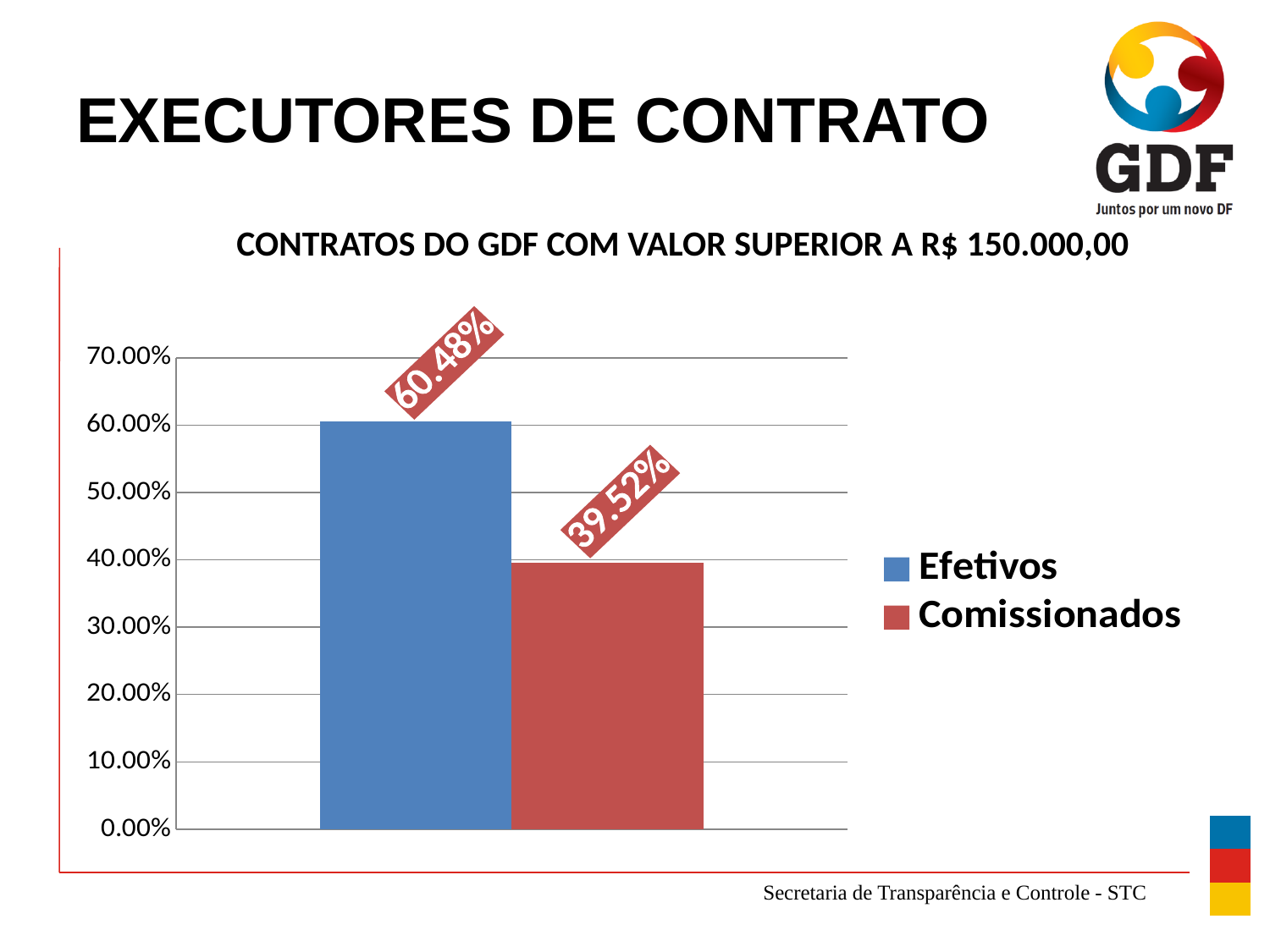
Is the value for Efetivos greater or less than 60.00%? greater What is the title of the chart? CONTRATOS DO GDF COM VALOR SUPERIOR A R$ 150.000,00 Which is larger, the value for Efetivos or the value for Comissionados? Efetivos What is the difference between the values for Efetivos and Comissionados? 20.96% Is the value for Comissionados greater or less than 40.00%? less How many series does the legend list? 2 Which series has the highest value? Efetivos What colour is the bar for Comissionados? red What is the value for Efetivos? 60.48% What kind of chart is shown on the slide? bar chart Which series has the lowest value? Comissionados What is the value for Comissionados? 39.52%